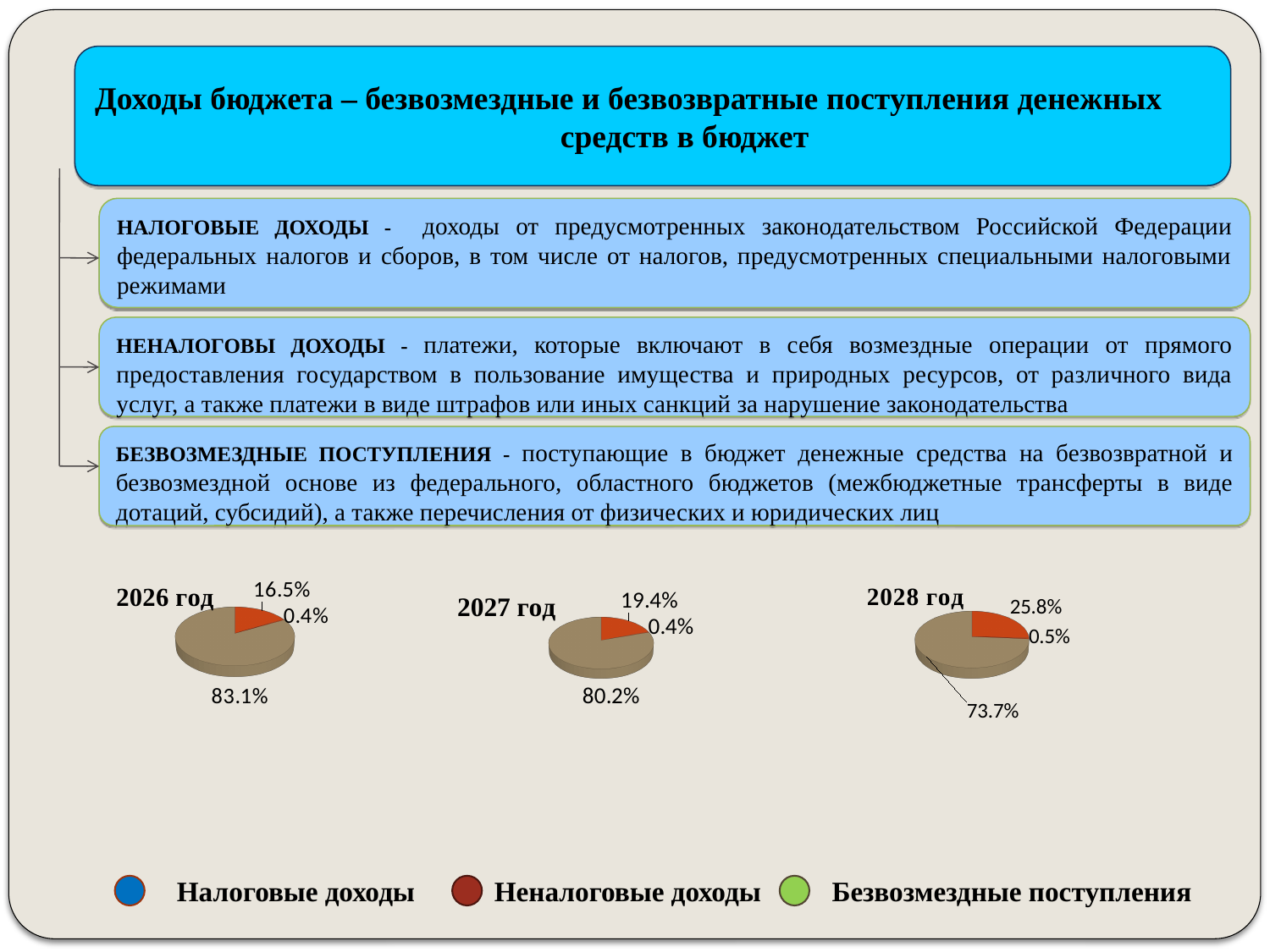
What kind of chart is used for the 2026 год, 2027 год and 2028 год data? Pie chart In the 2028 год pie chart, what is the value of the smallest slice? 0.5% Which pie chart has the larger largest slice, 2026 год or 2028 год? 2026 год In the 2026 год pie chart, what is the value of the smallest slice? 0.4% In the 2028 год pie chart, what is the value of the orange slice? 25.8% In the 2026 год pie chart, what is the value of the largest slice? 83.1% How many slices does each pie chart have? 3 In the 2028 год pie chart, what is the value of the largest slice? 73.7% In the 2027 год pie chart, what is the value of the orange slice? 19.4% How many pie charts are shown on the slide? 3 In the 2027 год pie chart, what is the value of the largest slice? 80.2% How many entries does the legend at the bottom of the slide list? 3